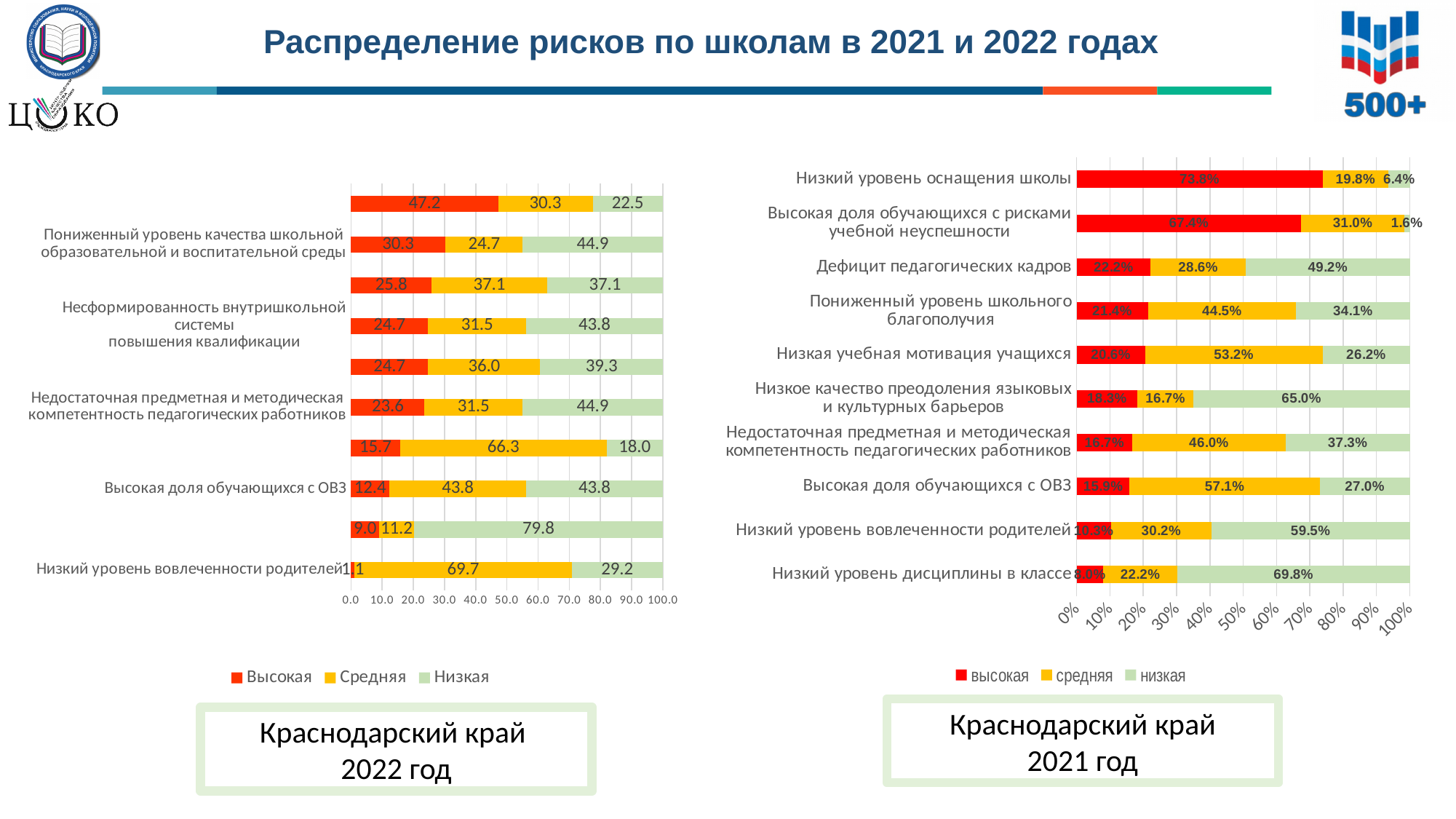
On the 2021 chart (Краснодарский край 2021 год), what is the value of the 'высокая' series for 'Низкий уровень оснащения школы'? 73.8% On the 2022 chart (Краснодарский край 2022 год), which is larger: the 'Низкая' value for 'Высокая доля обучающихся с ОВЗ' or the 'Низкая' value for 'Низкий уровень вовлеченности родителей'? Высокая доля обучающихся с ОВЗ On the 2021 chart (Краснодарский край 2021 год), how many categories are plotted? 10 On the 2021 chart (Краснодарский край 2021 год), what is the 'низкая' value for 'Низкий уровень дисциплины в классе'? 69.8% On the 2022 chart (Краснодарский край 2022 год), what is the 'Высокая' value for 'Пониженный уровень качества школьной образовательной и воспитательной среды'? 30.3 On the 2021 chart (Краснодарский край 2021 год), what is the difference between the 'средняя' values for 'Высокая доля обучающихся с ОВЗ' and 'Низкая учебная мотивация учащихся'? 3.9% On the 2022 chart (Краснодарский край 2022 год), what colour represents the 'Высокая' series? Red On the 2021 chart (Краснодарский край 2021 год), how many series does the legend list? 3 On the 2022 chart (Краснодарский край 2022 год), what is the 'Средняя' value for 'Низкий уровень вовлеченности родителей'? 69.7 What type of chart is the 2022 chart (Краснодарский край 2022 год)? Stacked bar chart On the 2021 chart (Краснодарский край 2021 год), which category has the highest 'высокая' value? Низкий уровень оснащения школы On the 2021 chart (Краснодарский край 2021 год), which category has the lowest 'высокая' value? Низкий уровень дисциплины в классе